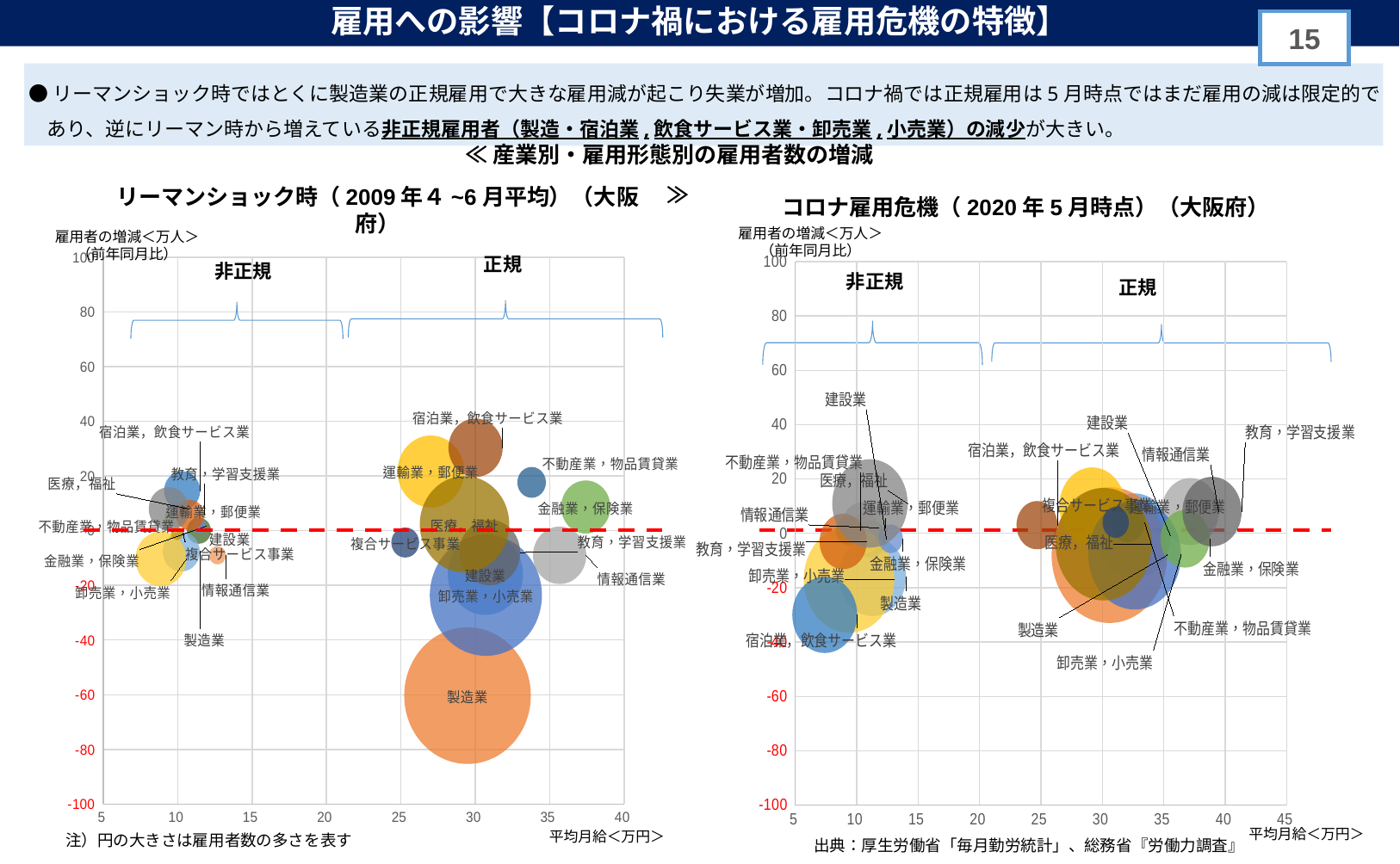
According to the note under the left chart, what does the size of each circle represent? 雇用者数の多さ In the left chart (リーマンショック時), is the value for 宿泊業，飲食サービス業 in the 正規 group greater or less than 20? greater In the left chart (リーマンショック時), is the value for 製造業 in the 正規 group greater or less than -40? less What kind of chart is the left chart, リーマンショック時（2009年4~6月平均）（大阪府）? bubble chart What is the x-axis label of the right chart (コロナ雇用危機)? 平均月給＜万円＞ In the left chart (リーマンショック時), which industry in the 正規 group has the lowest value? 製造業 In the left chart (リーマンショック時), is the value for 卸売業，小売業 in the 正規 group greater or less than 0? less What kind of chart is the right chart, コロナ雇用危機（2020年5月時点）（大阪府）? bubble chart In the left chart (リーマンショック時), which is larger in the 正規 group: 製造業 or 宿泊業，飲食サービス業? 宿泊業，飲食サービス業 In the right chart (コロナ雇用危機), which is larger: 宿泊業，飲食サービス業 in the 非正規 group or 教育，学習支援業 in the 正規 group? 教育，学習支援業 (正規)